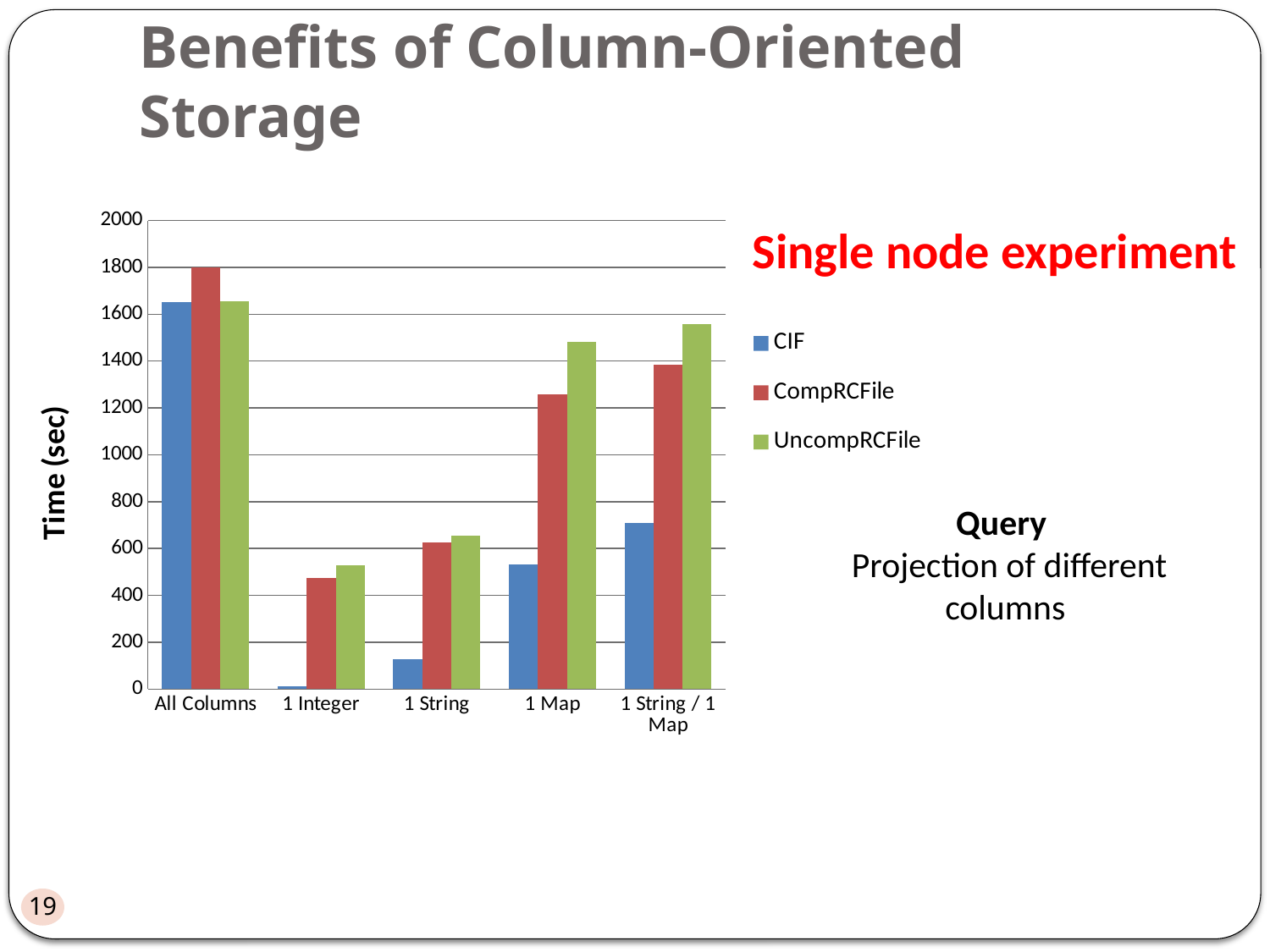
What kind of chart is shown on the slide? bar chart For All Columns, which is larger: CIF or CompRCFile? CompRCFile What colour represents the CIF series in the legend? blue How many series does the legend list? 3 Which category has the highest CompRCFile value? All Columns Is the CIF value for All Columns greater or less than 1400? greater What is the label of the y axis? Time (sec) Is the CompRCFile value for 1 Integer greater or less than 600? less Is the UncompRCFile value for 1 String / 1 Map greater or less than 1400? greater For 1 Map, which is larger: CompRCFile or UncompRCFile? UncompRCFile How many categories are shown on the x axis? 5 Which category has the lowest CIF value? 1 Integer